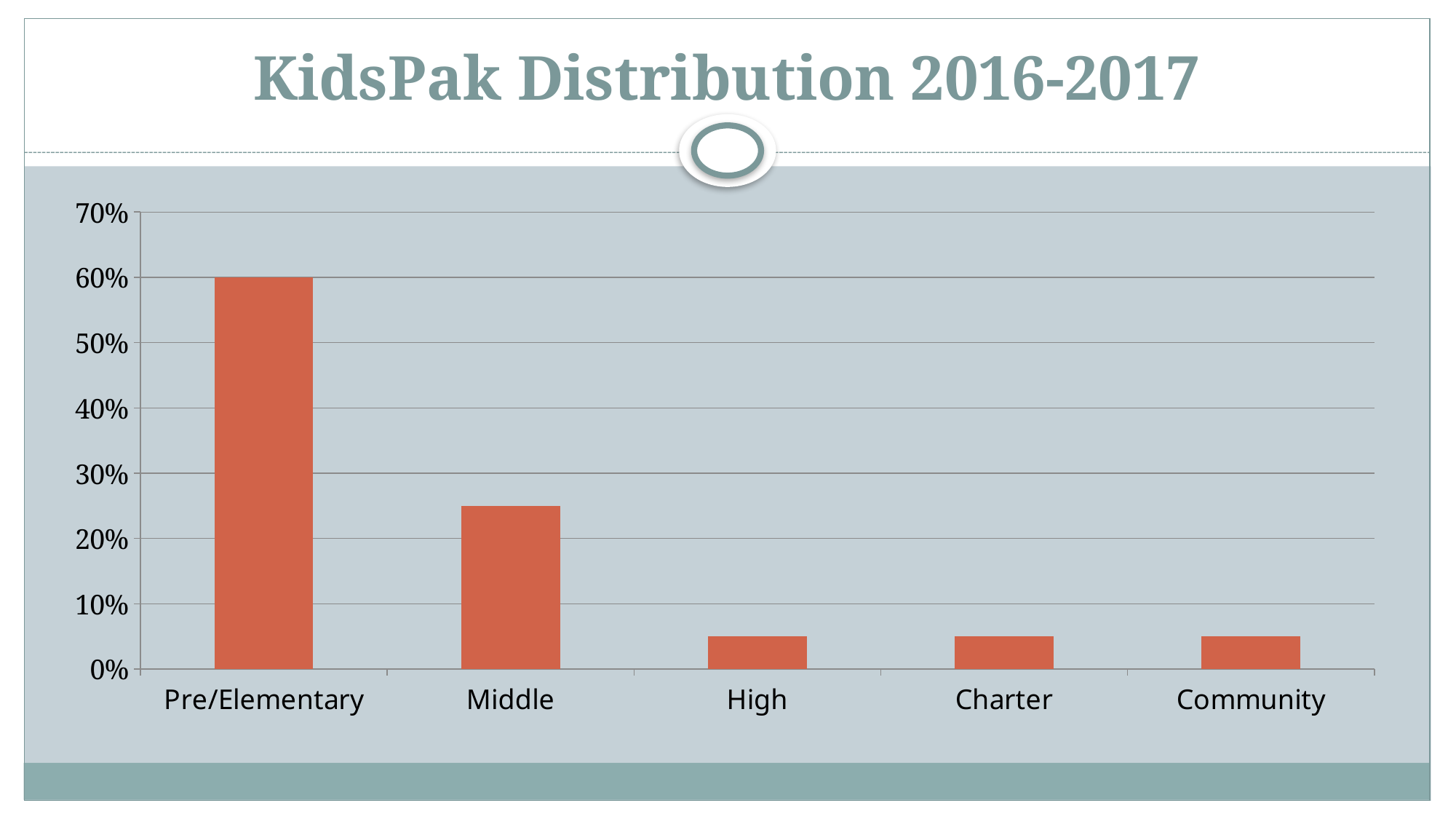
What is the value for Pre/Elementary? 60% How many categories are shown on the x axis? 5 Is the value for Community greater or less than 10%? less Is the value for Middle greater or less than 20%? greater What is the title of the slide? KidsPak Distribution 2016-2017 Which is larger, the value for Middle or the value for High? Middle Is the value for High greater or less than 10%? less What kind of chart is shown on the slide? Bar chart Which category has the highest value? Pre/Elementary Which is larger, the value for Pre/Elementary or the value for Middle? Pre/Elementary